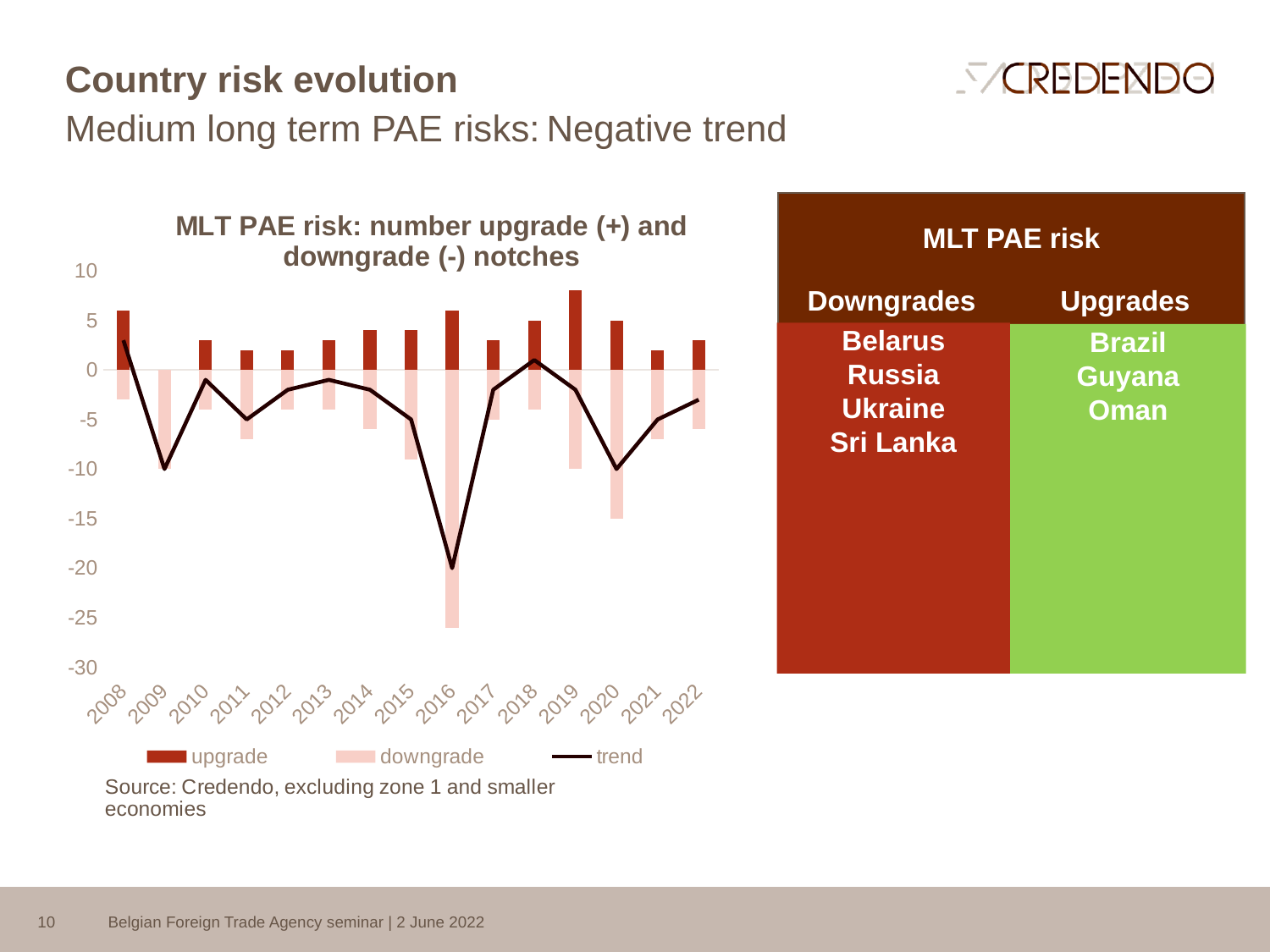
Is the downgrade value for 2016 greater or less than -20? less Which year has the larger upgrade value, 2019 or 2021? 2019 Is the downgrade value for 2015 greater or less than -5? less What is the source given below the chart? Credendo, excluding zone 1 and smaller economies In which year is the upgrade bar the highest? 2019 What kind of chart is shown on the slide? bar chart (with a trend line) How many years are shown on the x axis of the chart? 15 How many series does the chart legend list? 3 Is the upgrade value for 2019 greater or less than 5? greater What is the title of the chart? MLT PAE risk: number upgrade (+) and downgrade (-) notches Does the trend line rise or fall from 2019 to 2020? fall In which year is the downgrade bar the lowest (most negative)? 2016